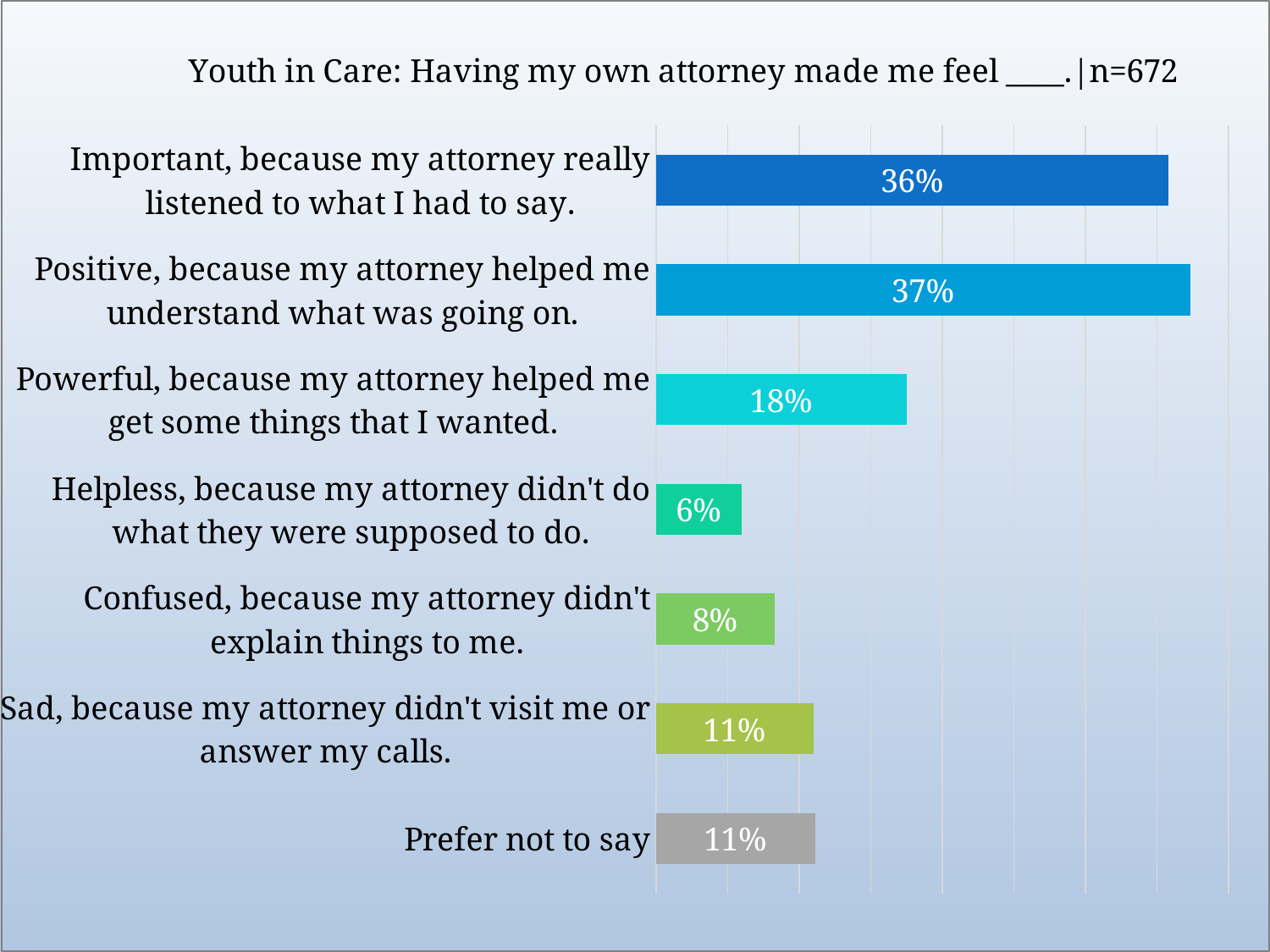
What is the difference in percentage points between the 'Positive' response and the 'Important' response? 1 What is the sample size (n) given in the chart title? 672 What is the difference in percentage points between the 'Powerful' response and the 'Confused' response? 10 Which response has the highest percentage? Positive, because my attorney helped me understand what was going on. How many response categories are shown in the chart? 7 What percentage of youth chose 'Prefer not to say'? 11% What percentage of youth said having their own attorney made them feel important because the attorney really listened? 36% What percentage of youth said they felt helpless because their attorney didn't do what they were supposed to do? 6% What percentage of youth said having their own attorney made them feel powerful because the attorney helped them get some things they wanted? 18% Which is larger: the percentage for 'Sad, because my attorney didn't visit me or answer my calls' or for 'Confused, because my attorney didn't explain things to me'? Sad, because my attorney didn't visit me or answer my calls. Which response has the lowest percentage? Helpless, because my attorney didn't do what they were supposed to do. What kind of chart is shown on the slide? Bar chart